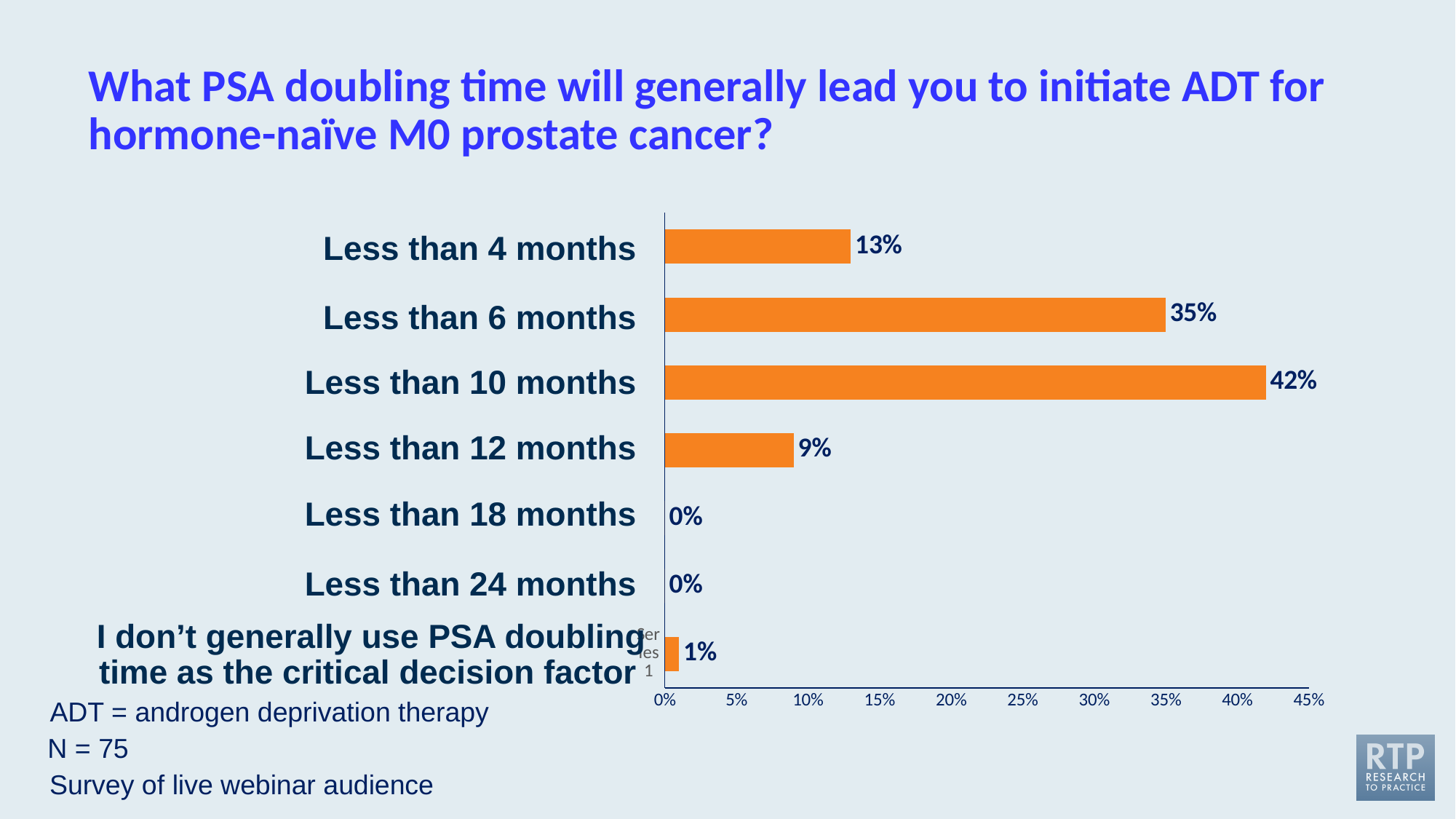
What is the maximum value shown on the horizontal axis? 45% What percentage of respondents chose "Less than 10 months"? 42% How many response categories are shown in the chart? 7 What type of chart is shown on the slide? Bar chart How many response categories received 0%? 2 What percentage of respondents said they don't generally use PSA doubling time as the critical decision factor? 1% What is the difference in percentage points between "Less than 4 months" and "Less than 12 months"? 4% Which received a larger share of responses, "Less than 6 months" or "Less than 12 months"? Less than 6 months Is the value for "Less than 6 months" greater or less than 30%? greater What is the difference in percentage points between "Less than 10 months" and "Less than 6 months"? 7% What percentage of respondents chose "Less than 4 months"? 13% Which PSA doubling time option received the highest percentage of responses? Less than 10 months